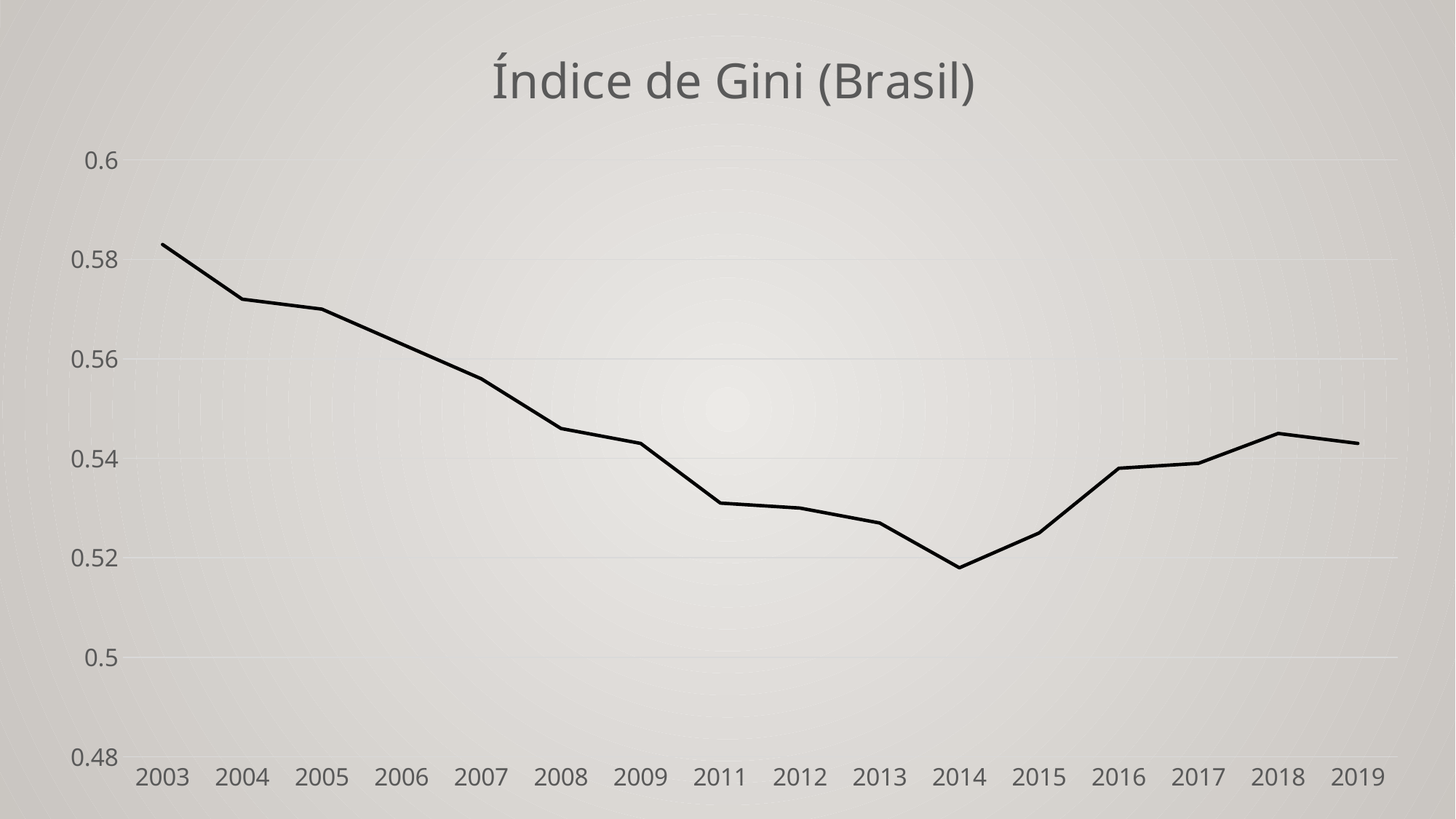
Is the value for 2014 greater or less than 0.52? less How many years are plotted along the x axis? 16 Which year has a larger value, 2005 or 2015? 2005 Is the value for 2008 greater or less than 0.54? greater Is the value for 2003 greater or less than 0.58? greater Which year has the highest Gini index value? 2003 Which year has a larger value, 2018 or 2013? 2018 What kind of chart is shown on the slide? line chart What is the title of the chart? Índice de Gini (Brasil) Which year has the lowest Gini index value? 2014 Does the Gini index rise or fall from 2003 to 2014? fall